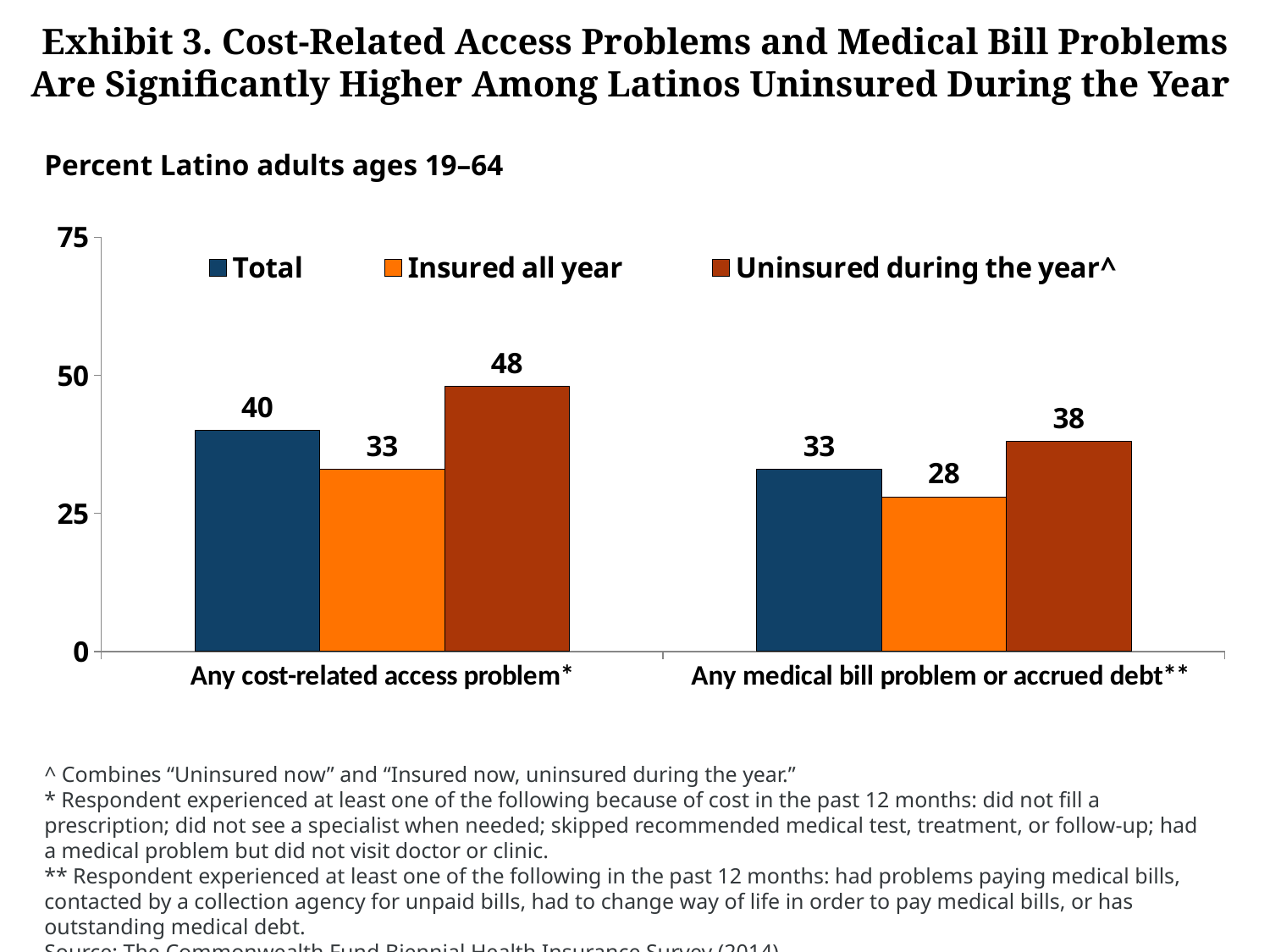
Is the value for Uninsured during the year^ for Any cost-related access problem* greater or less than 50? less Which series has the lowest value for Any medical bill problem or accrued debt**? Insured all year What is the value for Total for Any cost-related access problem*? 40 What is the value for Uninsured during the year^ for Any medical bill problem or accrued debt**? 38 Which is larger: the Insured all year value for Any cost-related access problem* or the Insured all year value for Any medical bill problem or accrued debt**? Any cost-related access problem* How many series does the legend list? 3 What is the value for Insured all year for Any medical bill problem or accrued debt**? 28 How many categories are shown on the x axis? 2 What kind of chart is shown on the slide? bar chart Which series has the highest value for Any cost-related access problem*? Uninsured during the year^ What is the difference between the Total values for Any cost-related access problem* and Any medical bill problem or accrued debt**? 7 What is the difference between the Uninsured during the year^ and Insured all year values for Any cost-related access problem*? 15